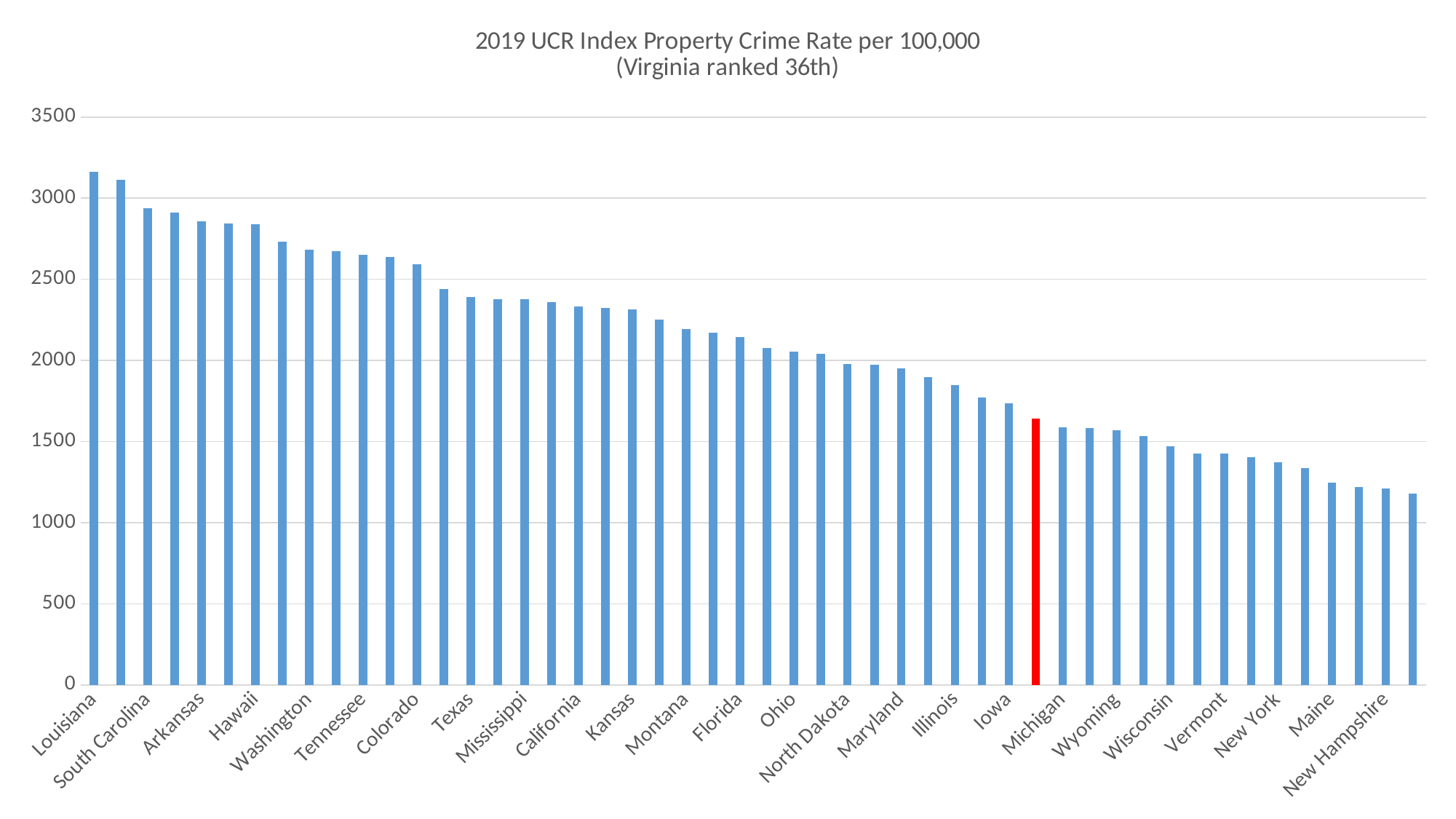
Which state has the highest property crime rate in the chart? Louisiana Is the value for Hawaii greater or less than 3000? less Which has the larger value, Texas or Florida? Texas Is the value for Texas greater or less than 2000? greater Is the value for Iowa greater or less than 1500? greater Which has the larger value, Maine or Hawaii? Hawaii What kind of chart is shown on the slide? bar chart Do the values rise or fall moving from left to right along the x axis? fall Which state does the red bar represent? Virginia What is the title of the chart? 2019 UCR Index Property Crime Rate per 100,000 (Virginia ranked 36th)